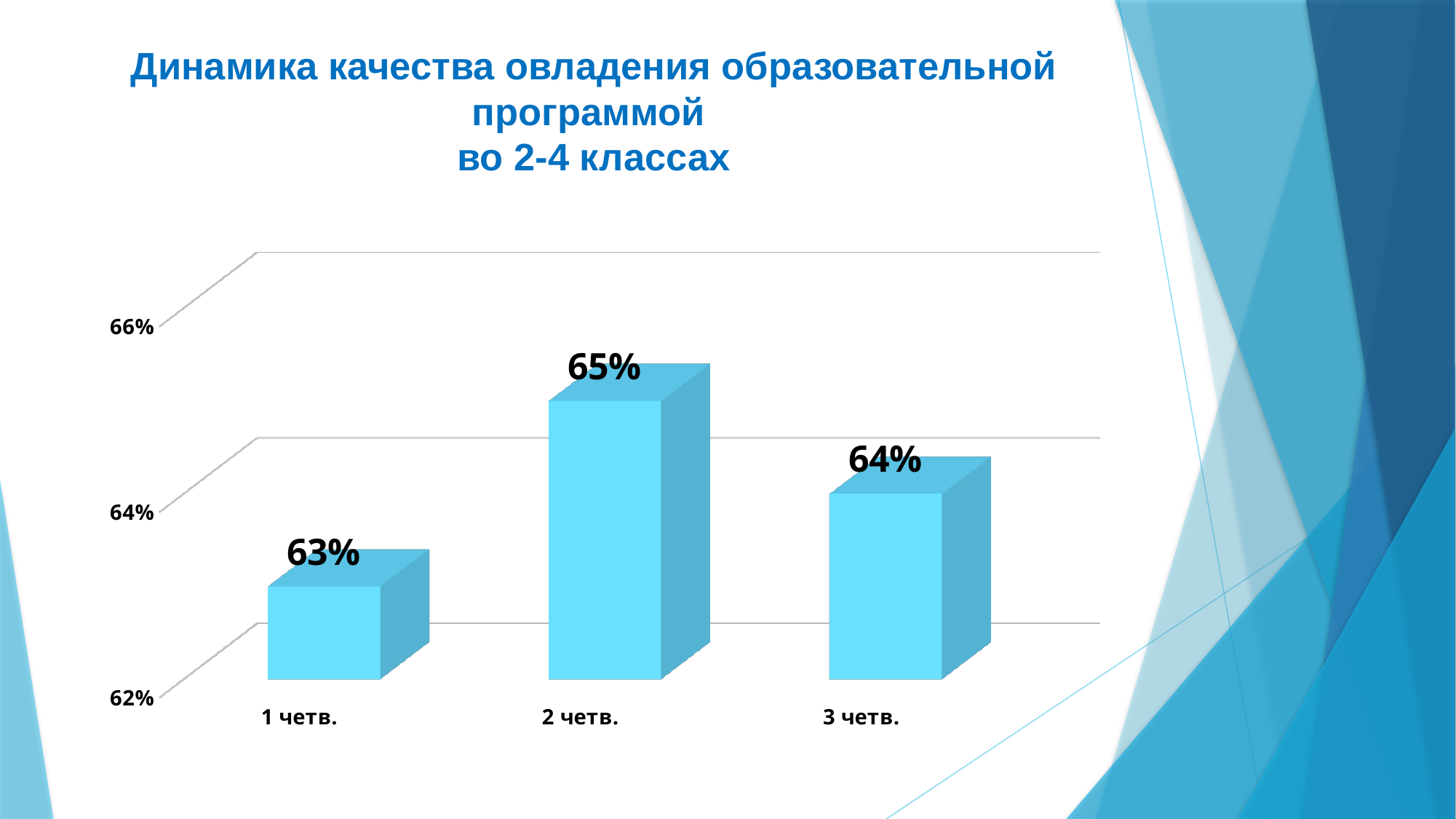
What kind of chart is shown on the slide? bar chart Which quarter has the highest value? 2 четв. What is the title of the slide? Динамика качества овладения образовательной программой во 2-4 классах Is the value for 2 четв. greater or less than 64%? greater What is the value for 1 четв.? 63% What is the value for 2 четв.? 65% What is the difference between the values for 2 четв. and 1 четв.? 2% Which quarter has the lowest value? 1 четв. What is the value for 3 четв.? 64% How many categories are shown on the x axis? 3 What is the difference between the values for 2 четв. and 3 четв.? 1% Which is larger, the value for 3 четв. or the value for 1 четв.? 3 четв.